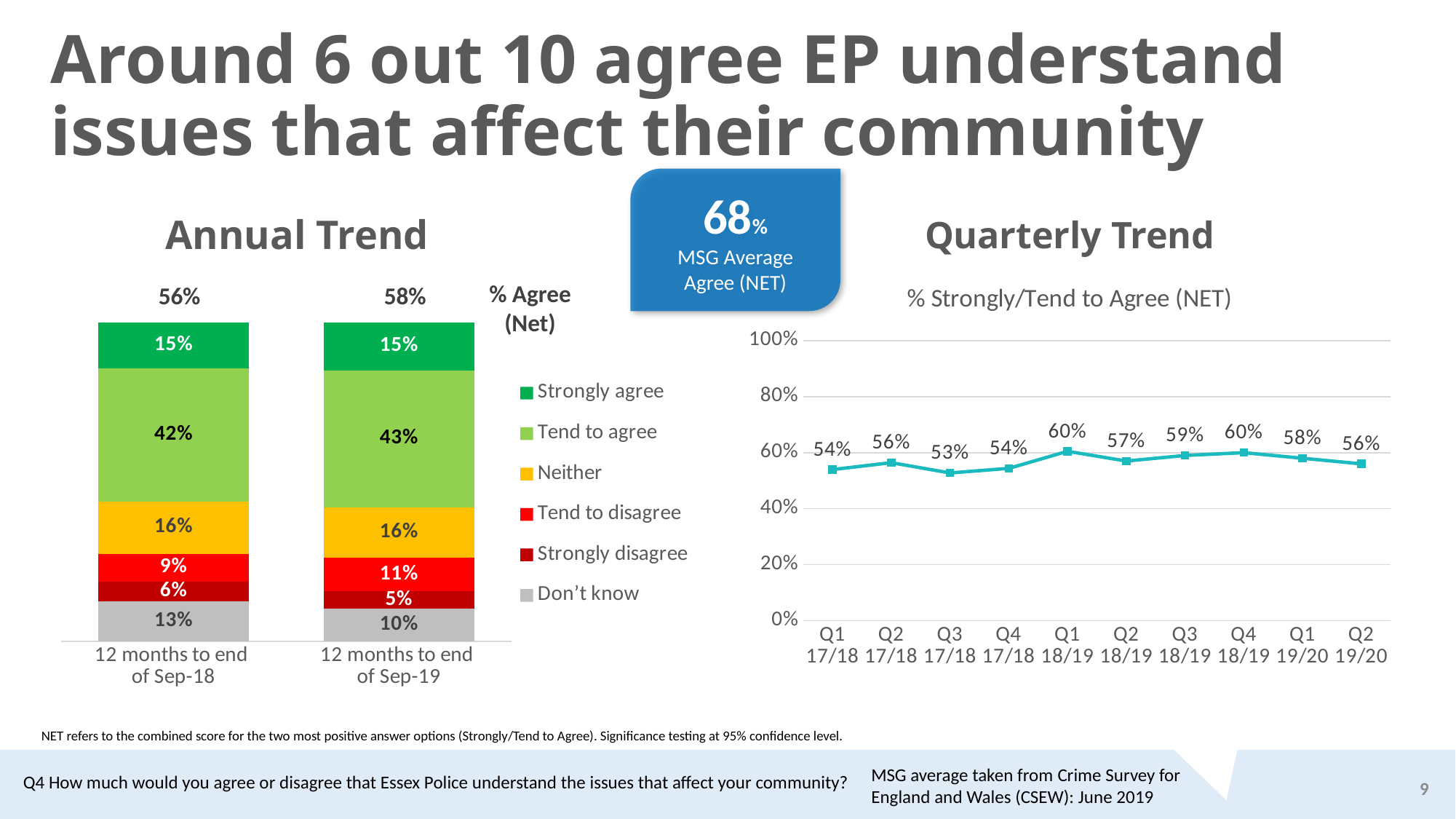
What value is shown in the blue box as the MSG Average Agree (NET)? 68% In the Quarterly Trend chart, which quarter has the lowest value? Q3 17/18 In the Annual Trend chart, what is the difference between the 'Tend to disagree' values for Sep-19 and Sep-18? 2% In the Annual Trend chart, what is the 'Don't know' value for the 12 months to end of Sep-18? 13% In the Annual Trend chart, what is the % Agree (Net) for the 12 months to end of Sep-19? 58% In the Annual Trend chart, what percentage of respondents said 'Tend to agree' in the 12 months to end of Sep-19? 43% What type of chart is the Quarterly Trend chart? Line chart In the Quarterly Trend chart, what is the value for Q1 18/19? 60% In the Annual Trend chart, how many series does the legend list? 6 In the Annual Trend chart, which period has the larger 'Strongly disagree' value, 12 months to end of Sep-18 or 12 months to end of Sep-19? 12 months to end of Sep-18 In the Quarterly Trend chart, what is the difference between the values for Q4 18/19 and Q2 19/20? 4% In the Quarterly Trend chart, how many quarters are plotted? 10